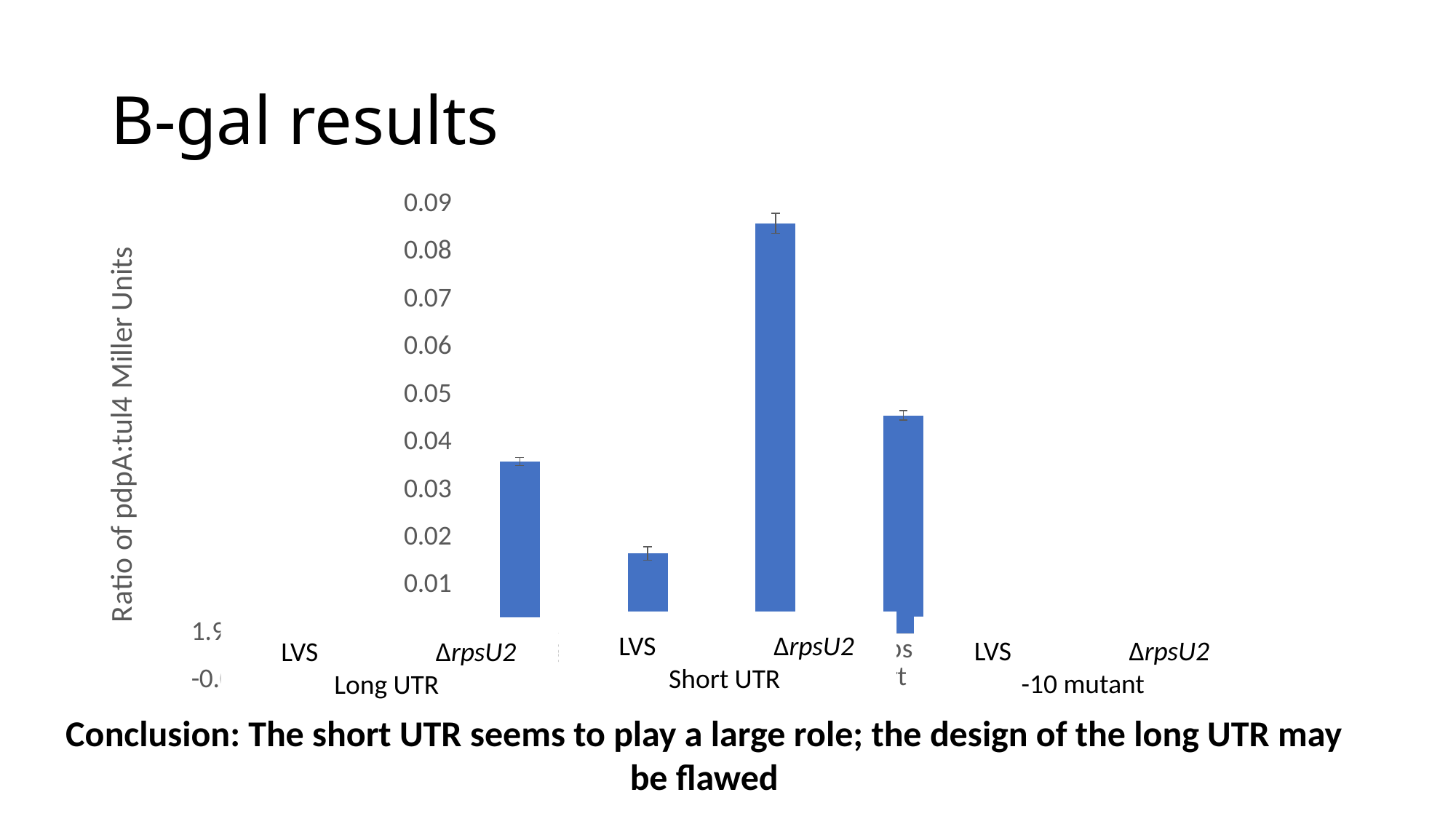
Is the value of the tallest bar greater or less than 0.09? less Which bar is taller, the third bar from the left or the rightmost bar? the third bar from the left Is the value of the tallest bar greater or less than 0.08? greater What kind of chart is shown on the slide? bar chart Is the value of the rightmost bar greater or less than 0.05? less Which bar is taller, the leftmost bar or the second bar from the left? the leftmost bar What is the title of the vertical axis of the chart? Ratio of pdpA:tul4 Miller Units Which group label on the x axis sits under the tallest bar? Short UTR What is the highest tick value shown on the vertical axis? 0.09